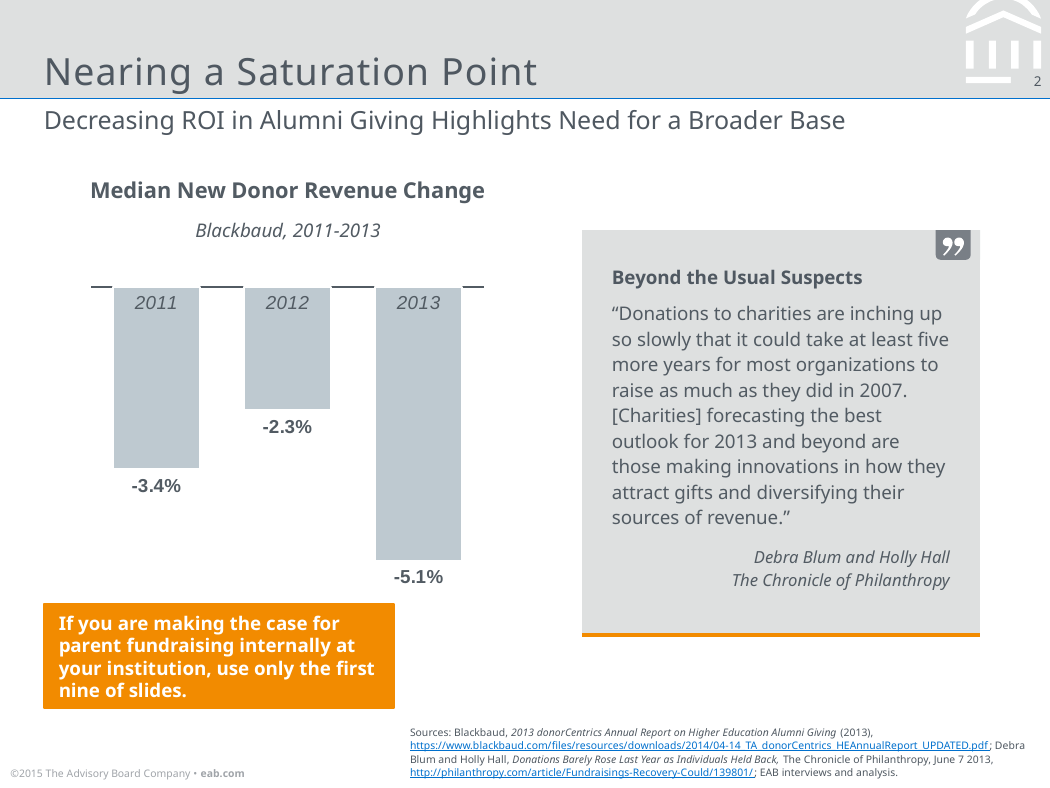
What is the median new donor revenue change for 2011? -3.4% By how many percentage points does the 2013 value differ from the 2011 value? 1.7 percentage points By how many percentage points does the 2012 value differ from the 2011 value? 1.1 percentage points What is the median new donor revenue change for 2013? -5.1% Which year shows the largest decline in median new donor revenue? 2013 How many years are plotted in the chart? 3 What is the title of the chart? Median New Donor Revenue Change Which year has a lower median new donor revenue change, 2011 or 2013? 2013 What is the median new donor revenue change for 2012? -2.3% What type of chart is used to show the median new donor revenue change? Bar chart Which year shows the smallest decline in median new donor revenue? 2012 Are all the values plotted in the chart negative? Yes